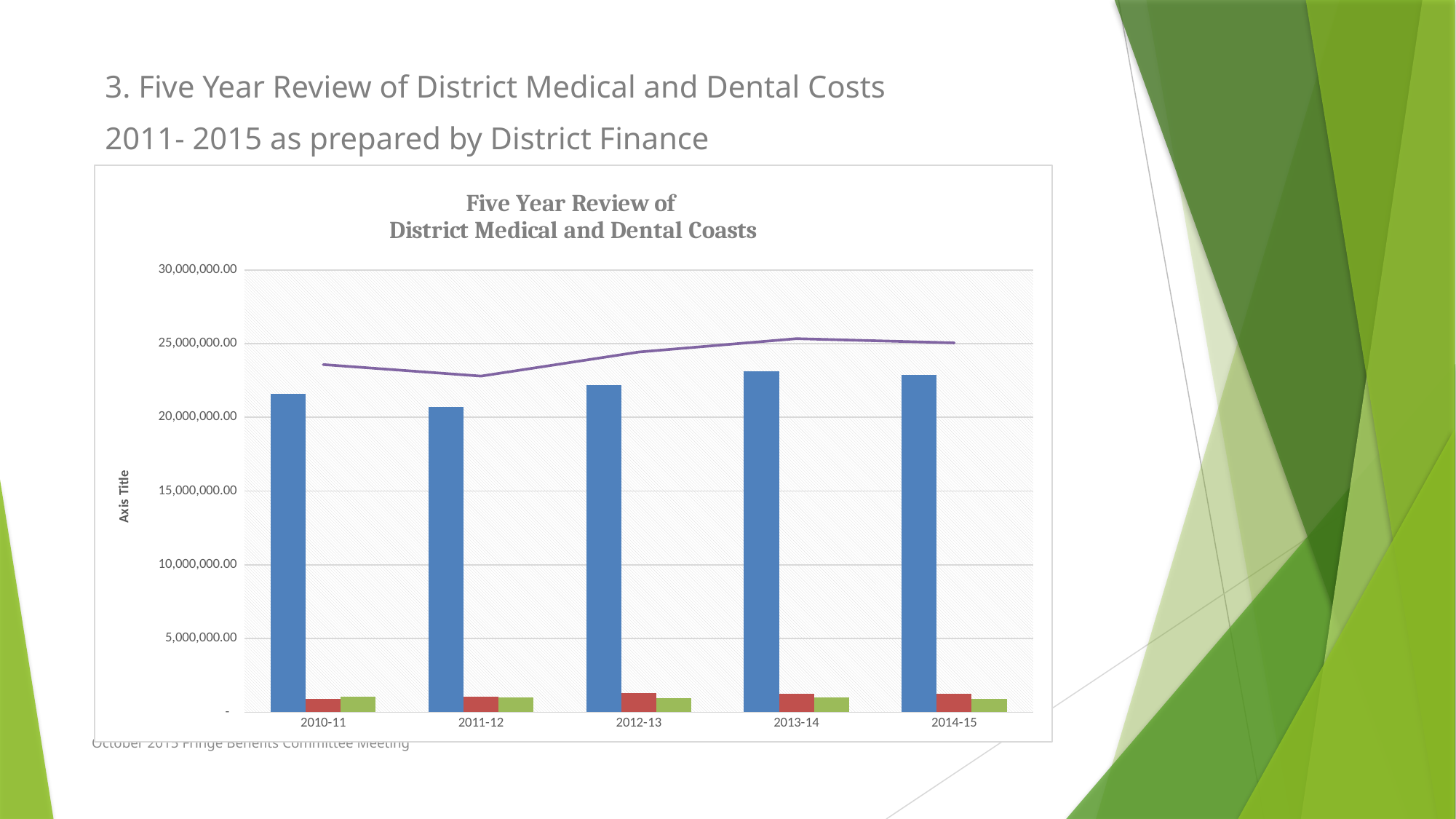
What is the title of the chart? Five Year Review of District Medical and Dental Coasts What kind of chart is this? Bar chart with a line overlay Is the value of the blue bar for 2013-14 greater or less than 25,000,000.00? less What is the label shown on the vertical axis? Axis Title How many fiscal-year categories are shown on the x axis? 5 Which year has the lowest blue bar? 2011-12 Which blue bar is taller, 2011-12 or 2012-13? 2012-13 Does the purple line rise or fall from 2011-12 to 2013-14? rise Is the value of the blue bar for 2010-11 greater or less than 20,000,000.00? greater Is the value of the red bar for 2012-13 greater or less than 5,000,000.00? less Which year has the lowest point on the purple line? 2011-12